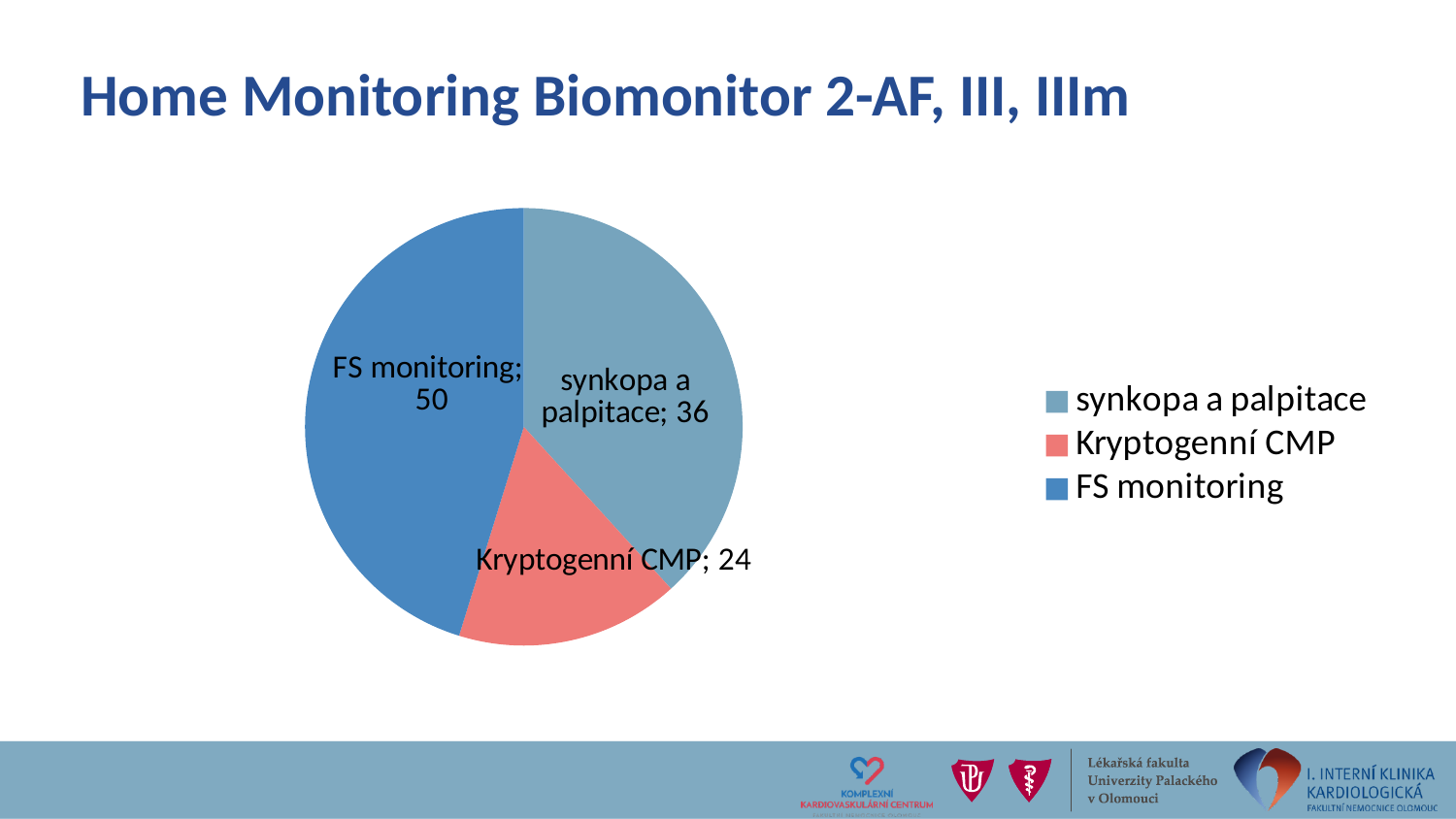
What is the difference between the values for synkopa a palpitace and Kryptogenní CMP? 12 What is the value for FS monitoring? 50 Which is larger, the value for synkopa a palpitace or the value for FS monitoring? FS monitoring What is the total of all slices in the pie chart? 110 How many slices does the pie chart have? 3 What is the difference between the values for FS monitoring and Kryptogenní CMP? 26 Which category has the smallest slice? Kryptogenní CMP What is the title of the slide containing the chart? Home Monitoring Biomonitor 2-AF, III, IIIm Which category has the largest slice? FS monitoring What is the value for Kryptogenní CMP? 24 What is the value for synkopa a palpitace? 36 What kind of chart is shown on the slide? pie chart